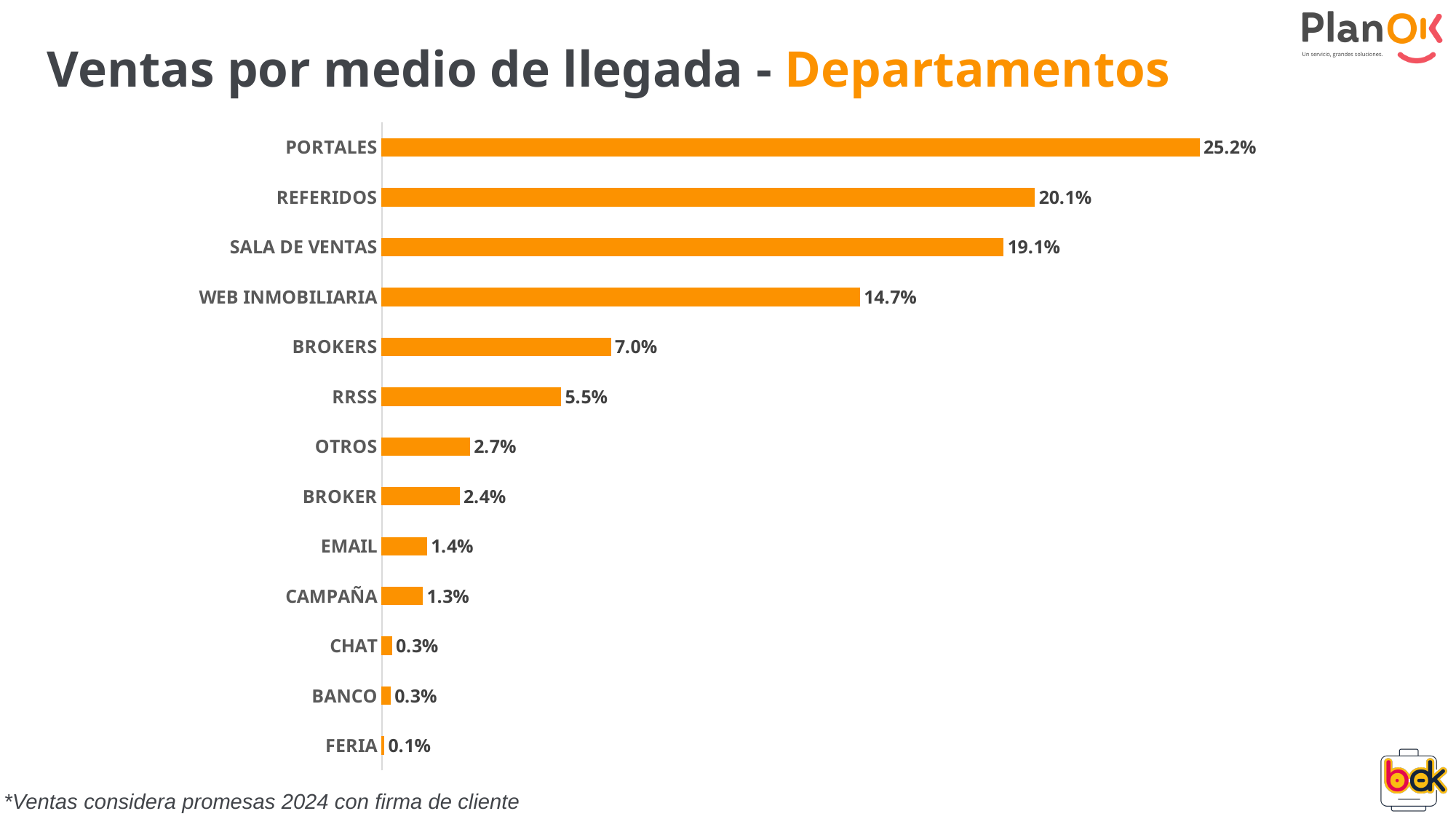
What is the difference between the values for PORTALES and REFERIDOS? 5.1% Which category has the lowest value? FERIA What is the difference between the values for BROKERS and RRSS? 1.5% What is the value for WEB INMOBILIARIA? 14.7% What is the title of the slide? Ventas por medio de llegada - Departamentos Which is larger, the value for SALA DE VENTAS or the value for WEB INMOBILIARIA? SALA DE VENTAS What is the value for PORTALES? 25.2% Which is larger, the value for OTROS or the value for BROKER? OTROS What is the value for RRSS? 5.5% How many categories are shown in the chart? 13 What kind of chart is shown on the slide? Bar chart Which category has the highest value? PORTALES